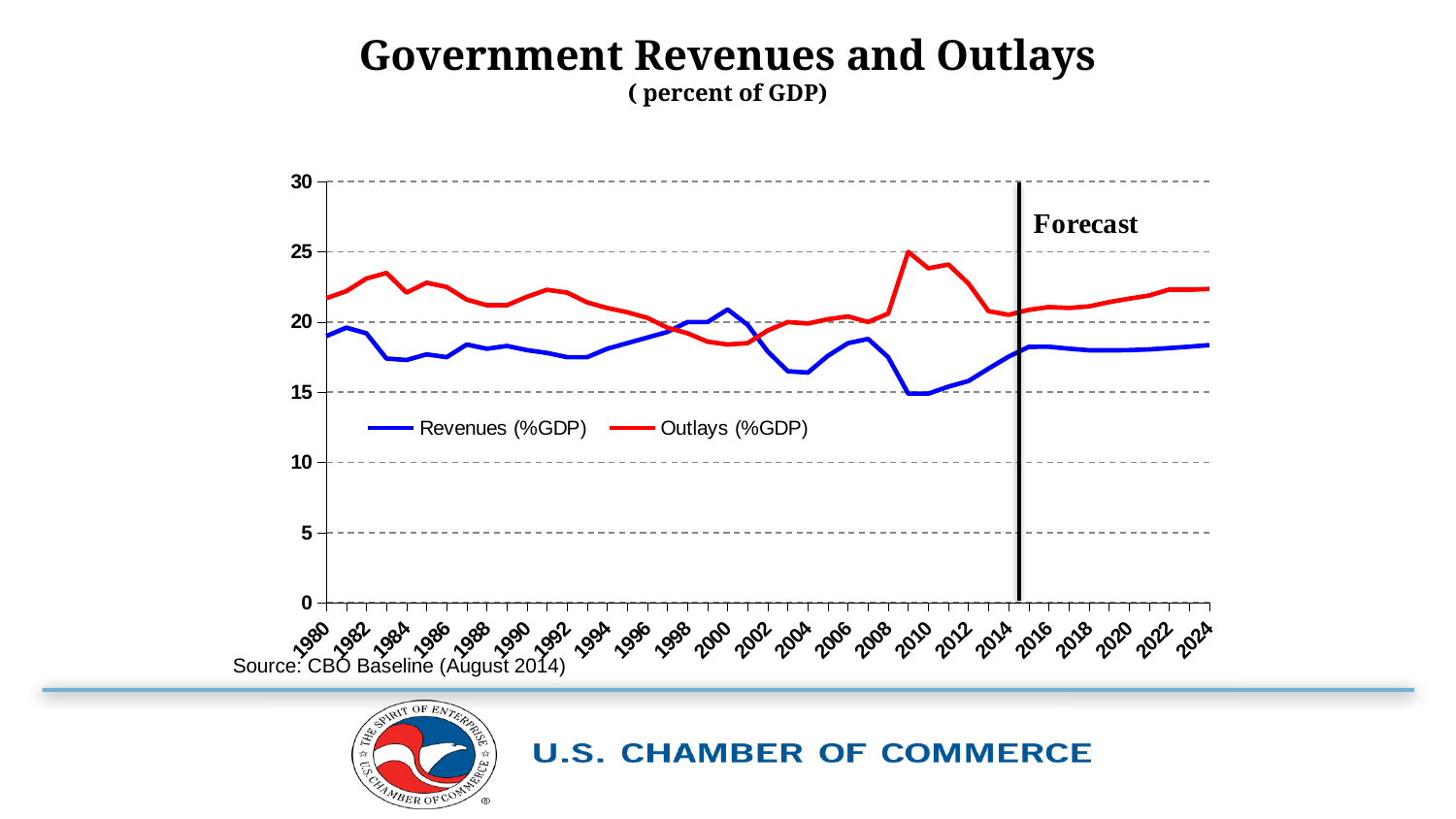
In which year does the Outlays (%GDP) line reach its highest point? 2009 What kind of chart is shown on the slide? line chart How many year labels are shown on the x axis? 23 How many series does the legend list? 2 Is the value for Revenues (%GDP) in 1980 greater or less than 15? greater Do Outlays (%GDP) rise or fall between 2009 and 2014? fall Is the value for Outlays (%GDP) in 2009 greater or less than 20? greater In 2000, which is higher, Revenues (%GDP) or Outlays (%GDP)? Revenues (%GDP) What are the two series named in the legend? Revenues (%GDP) and Outlays (%GDP) In 2010, which is higher, Revenues (%GDP) or Outlays (%GDP)? Outlays (%GDP) Is the value for Revenues (%GDP) in 2010 greater or less than 20? less What does the vertical black line on the chart mark? Forecast